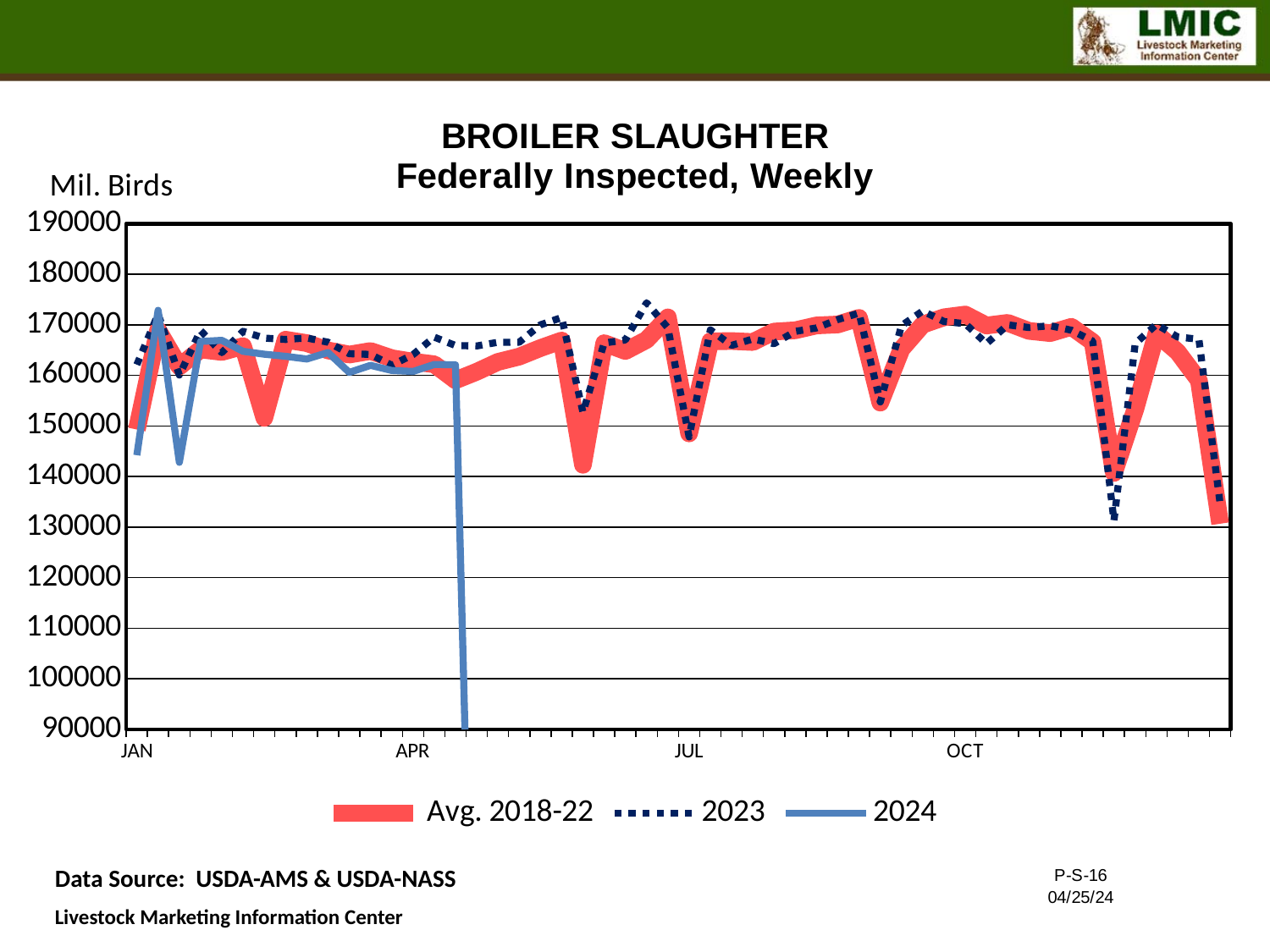
What kind of chart is shown on the slide? line chart How many series does the legend list? 3 Is the peak value of the 2024 series in January greater or less than 170000? greater Is the lowest value of the 2024 series in late January greater or less than 150000? less Is the highest value of the 2023 series in late June greater or less than 170000? greater In the late November dip, which series falls lower, 2023 or Avg. 2018-22? 2023 What is the title of the chart? BROILER SLAUGHTER Federally Inspected, Weekly How many month labels are shown on the x axis? 4 What unit is shown on the y-axis label? Mil. Birds